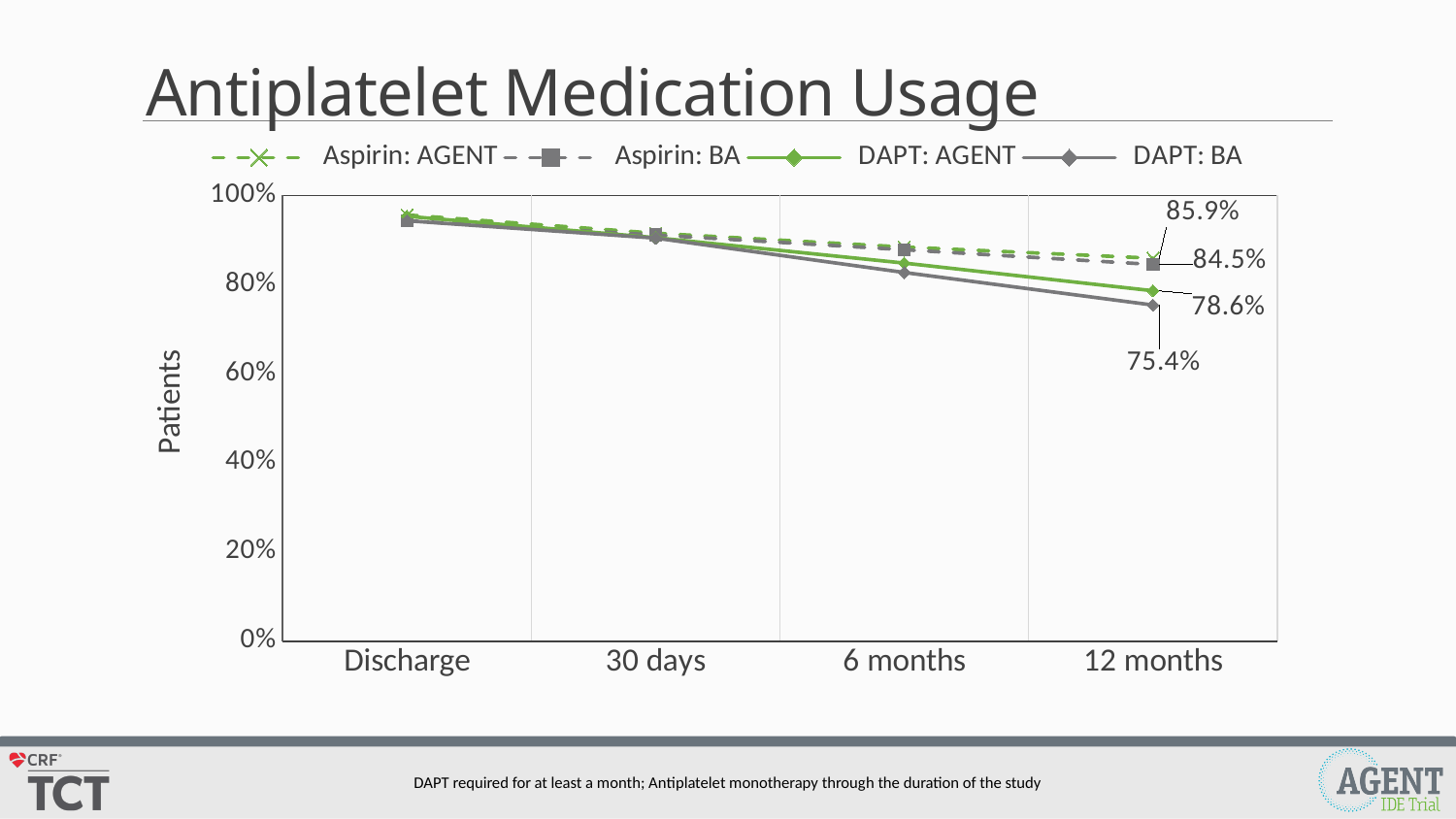
What is the difference between DAPT: AGENT and DAPT: BA at 12 months? 3.2% What is the value for DAPT: BA at 12 months? 75.4% How many series does the legend list? 4 What kind of chart is shown on the slide? Line chart Which series has the lowest value at 12 months? DAPT: BA What is the value for Aspirin: BA at 12 months? 84.5% What is the value for DAPT: AGENT at 12 months? 78.6% At 12 months, which is larger: DAPT: AGENT or DAPT: BA? DAPT: AGENT Do the values for DAPT: BA rise or fall from Discharge to 12 months? Fall Is the value for DAPT: BA at 6 months greater or less than 80%? greater What is the value for Aspirin: AGENT at 12 months? 85.9% What is the difference between Aspirin: AGENT and DAPT: AGENT at 12 months? 7.3%